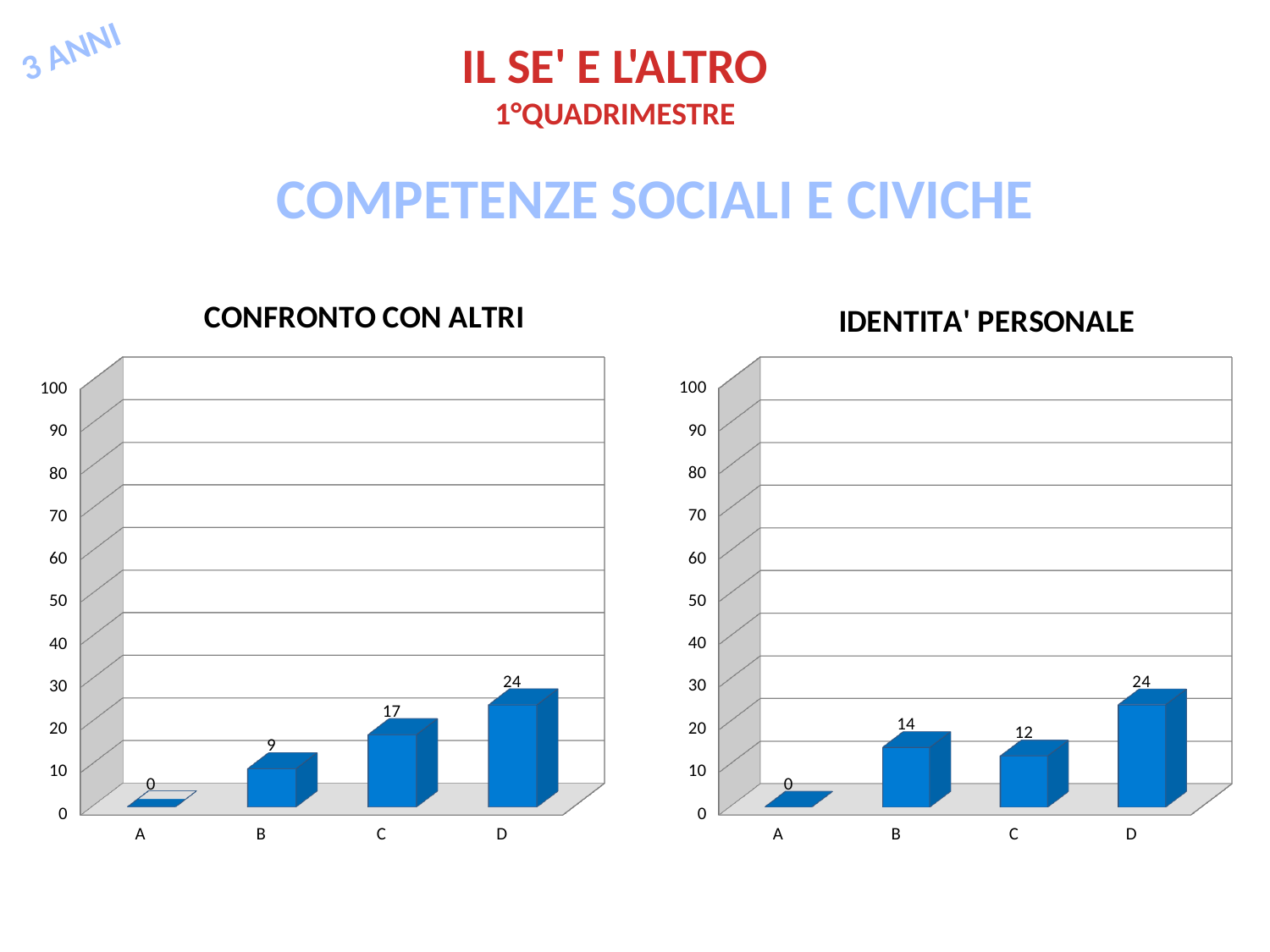
In the IDENTITA' PERSONALE chart, what is the difference between the values for D and C? 12 What is the title of the chart on the left of the slide? CONFRONTO CON ALTRI In the IDENTITA' PERSONALE chart, which category has the lowest value? A In the CONFRONTO CON ALTRI chart, do the values rise or fall from A to D? rise In the CONFRONTO CON ALTRI chart, what is the difference between the values for D and B? 15 In the CONFRONTO CON ALTRI chart, what is the value for category C? 17 How many categories are shown on the x axis of the CONFRONTO CON ALTRI chart? 4 In the IDENTITA' PERSONALE chart, is the value for D greater or less than 20? greater In the CONFRONTO CON ALTRI chart, which category has the highest value? D In the IDENTITA' PERSONALE chart, which is larger, the value for B or the value for C? B In the IDENTITA' PERSONALE chart, what is the value for category B? 14 What kind of chart is the IDENTITA' PERSONALE chart? bar chart